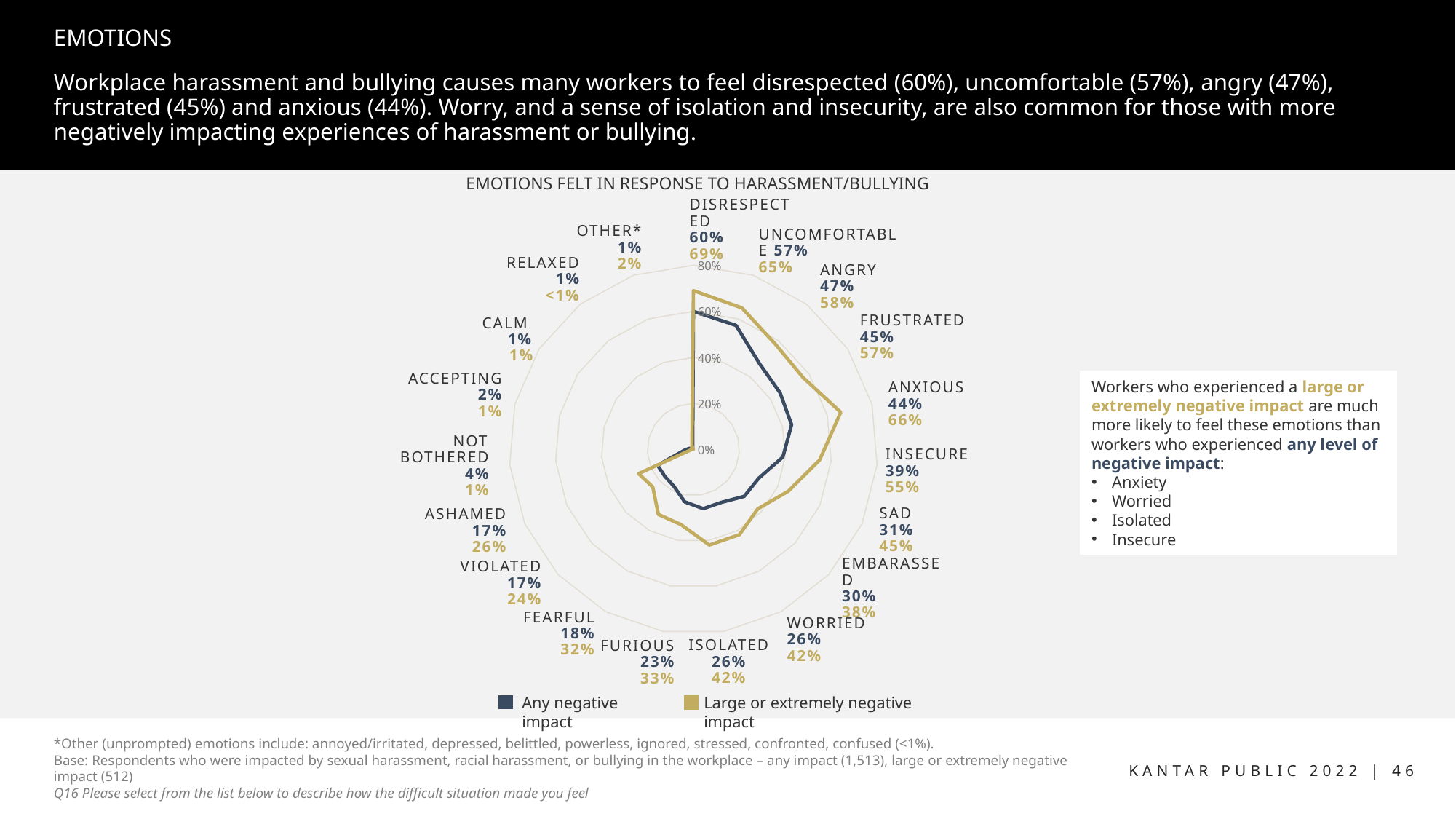
Which emotion has the highest value in the 'Any negative impact' series? Disrespected What is the value for Insecure in the 'Any negative impact' series? 39% What is the value for Anxious in the 'Large or extremely negative impact' series? 66% What is the difference between the 'Any negative impact' values for Disrespected and Uncomfortable? 3 percentage points What is the title of the radar chart? EMOTIONS FELT IN RESPONSE TO HARASSMENT/BULLYING What kind of chart is shown on the slide? Radar chart How many emotion categories are plotted on the radar chart? 19 Which emotion has the lowest value in the 'Large or extremely negative impact' series? Relaxed What is the value for Worried in the 'Large or extremely negative impact' series? 42% How many series does the legend list? 2 Which is larger for Not bothered: the 'Any negative impact' value or the 'Large or extremely negative impact' value? Any negative impact What is the difference between the 'Large or extremely negative impact' and 'Any negative impact' values for Anxious? 22 percentage points